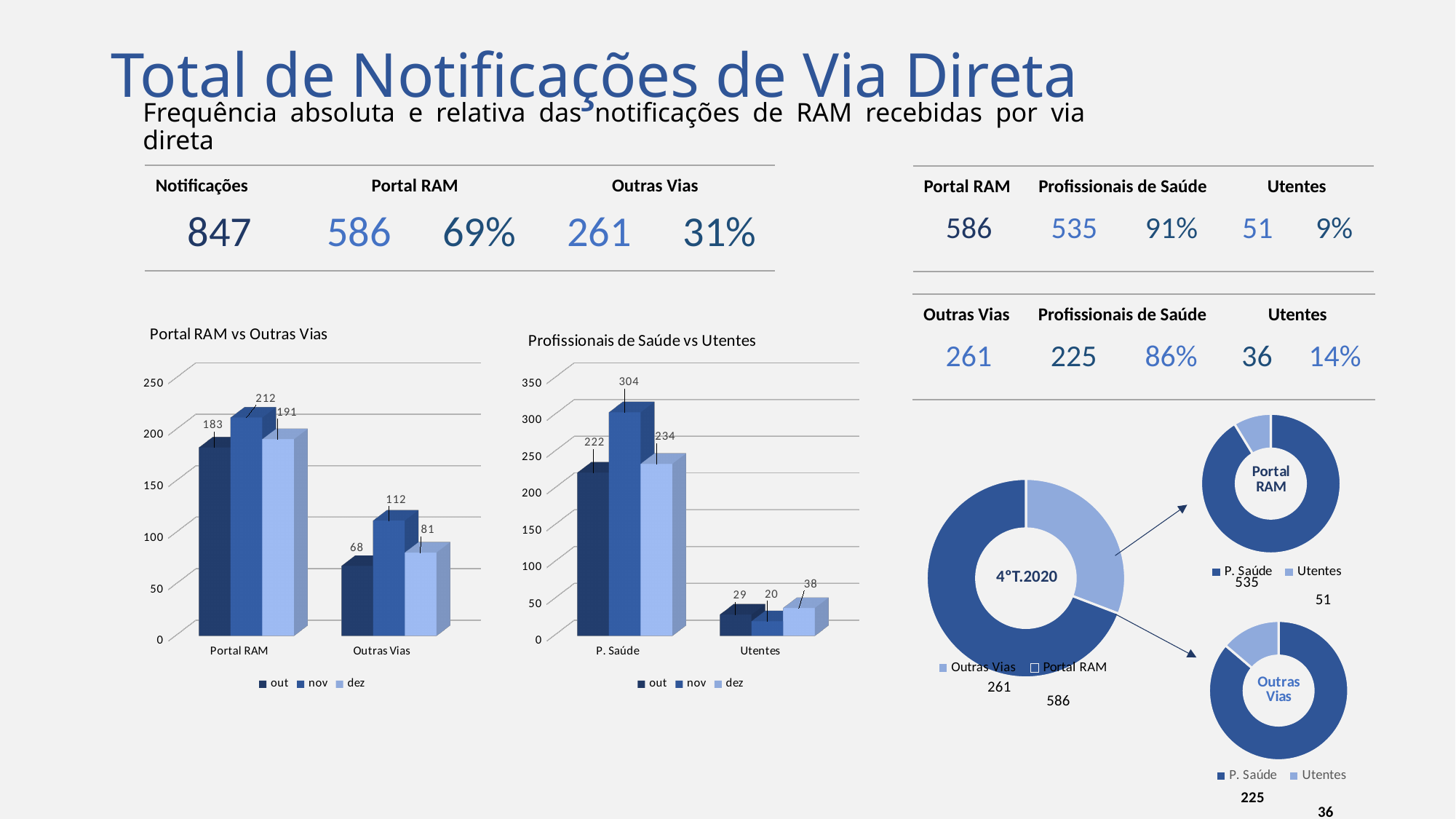
In the 'Portal RAM vs Outras Vias' chart, how many series does the legend list? 3 In the 'Profissionais de Saúde vs Utentes' chart, what is the value for Utentes in dez? 38 In the 'Portal RAM vs Outras Vias' chart, what is the value for Outras Vias in out? 68 In the '4°T.2020' donut chart, which category is larger: Outras Vias or Portal RAM? Portal RAM In the small 'Outras Vias' donut chart at the bottom right, what is the value for P. Saúde? 225 In the 'Profissionais de Saúde vs Utentes' chart, which is larger for Utentes: out or nov? out In the 'Portal RAM vs Outras Vias' chart, what is the difference between the nov and dez values for Outras Vias? 31 In the '4°T.2020' donut chart, what is the value for Portal RAM? 586 What kind of chart is the 'Profissionais de Saúde vs Utentes' chart? bar chart In the 'Profissionais de Saúde vs Utentes' chart, which month has the highest value for P. Saúde? nov In the 'Portal RAM vs Outras Vias' chart, what is the value for Portal RAM in nov? 212 In the 'Profissionais de Saúde vs Utentes' chart, what is the difference between the nov and out values for P. Saúde? 82